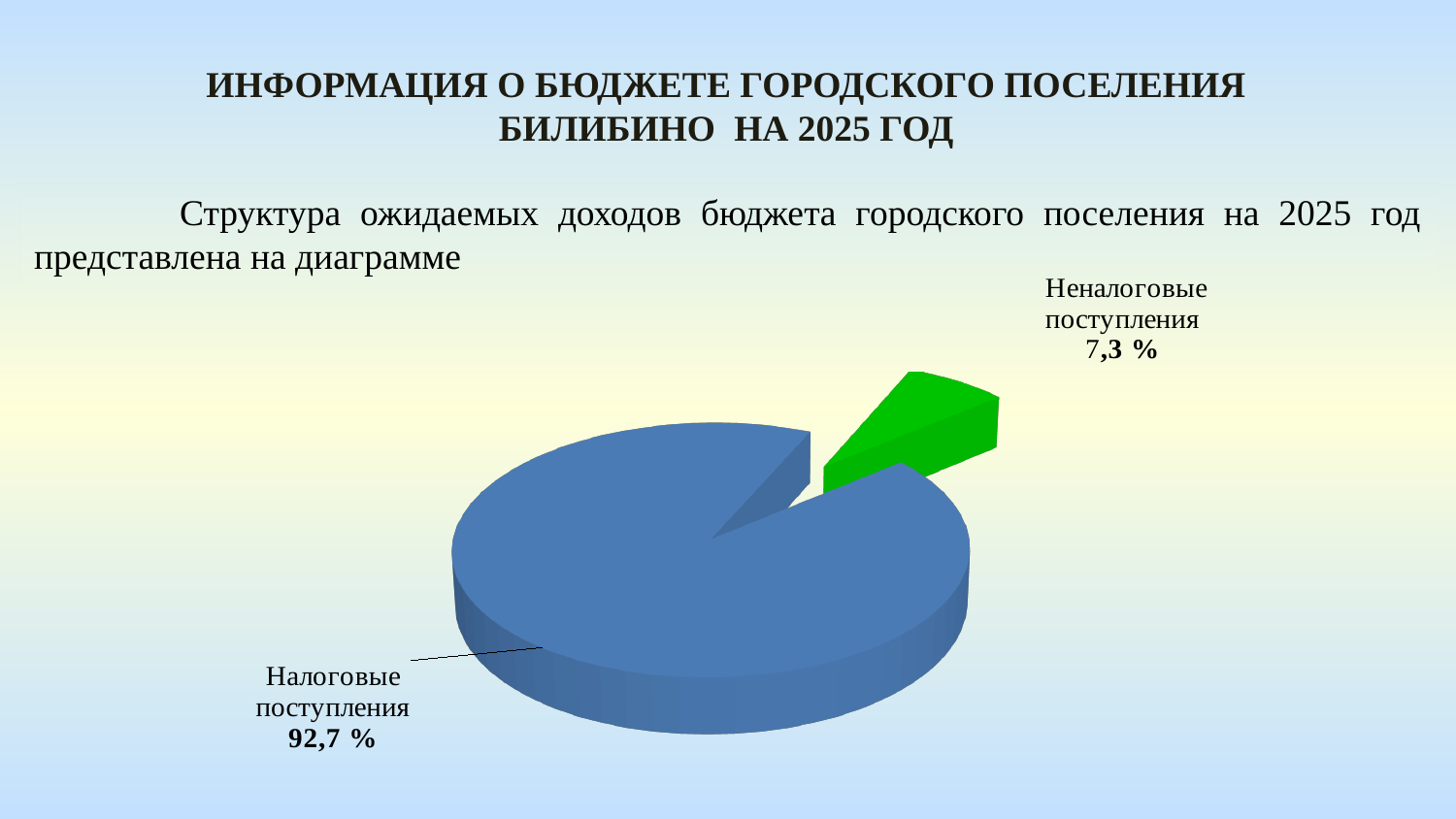
What kind of chart is shown on the slide? Pie chart Which slice of the pie is the largest? Налоговые поступления What is the total of the two slices shown in the pie chart? 100 % What share of the pie is labelled Налоговые поступления? 92,7 % How many slices does the pie chart have? 2 Which slice of the pie is the smallest? Неналоговые поступления What colour is the slice for Неналоговые поступления? Green What colour is the slice for Налоговые поступления? Blue What is the difference in percentage points between Налоговые поступления and Неналоговые поступления? 85,4 Which is larger, Налоговые поступления or Неналоговые поступления? Налоговые поступления What share of the pie is labelled Неналоговые поступления? 7,3 %